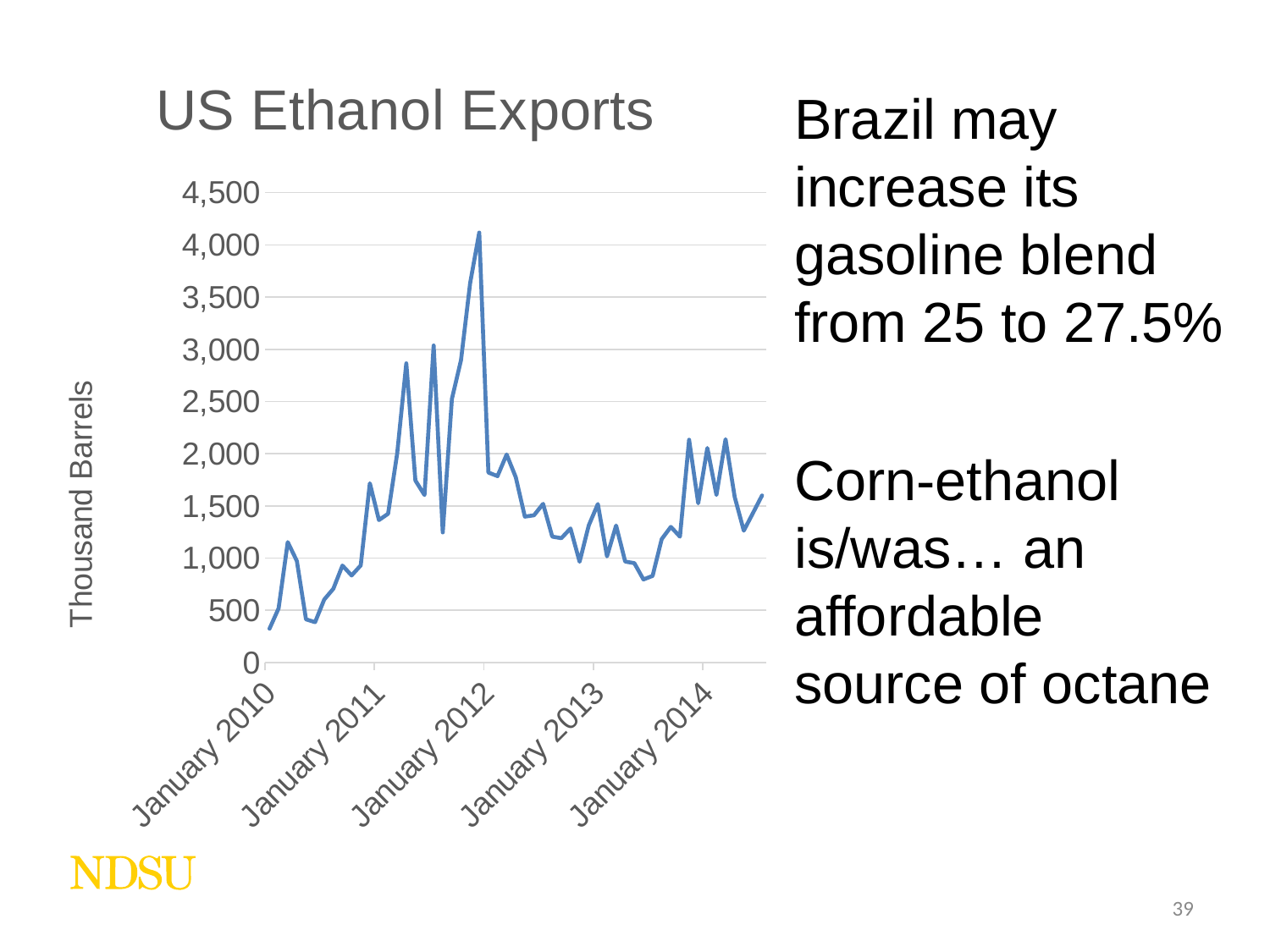
Around which labeled date does the line reach its highest value? January 2012 Is the highest value on the chart greater or less than 3,500? greater Does the line generally rise or fall between January 2010 and January 2012? rise Is the value at January 2010 greater or less than 500? less What is the label on the vertical axis of the chart? Thousand Barrels What kind of chart is shown on the slide? line chart How many lines are plotted on the chart? 1 Is the value at January 2011 greater or less than 1,000? greater How many labeled dates are shown on the x axis of the chart? 5 Does the line generally rise or fall between January 2012 and January 2013? fall Which is larger, the value at January 2012 or the value at January 2010? January 2012 What is the title of the chart? US Ethanol Exports